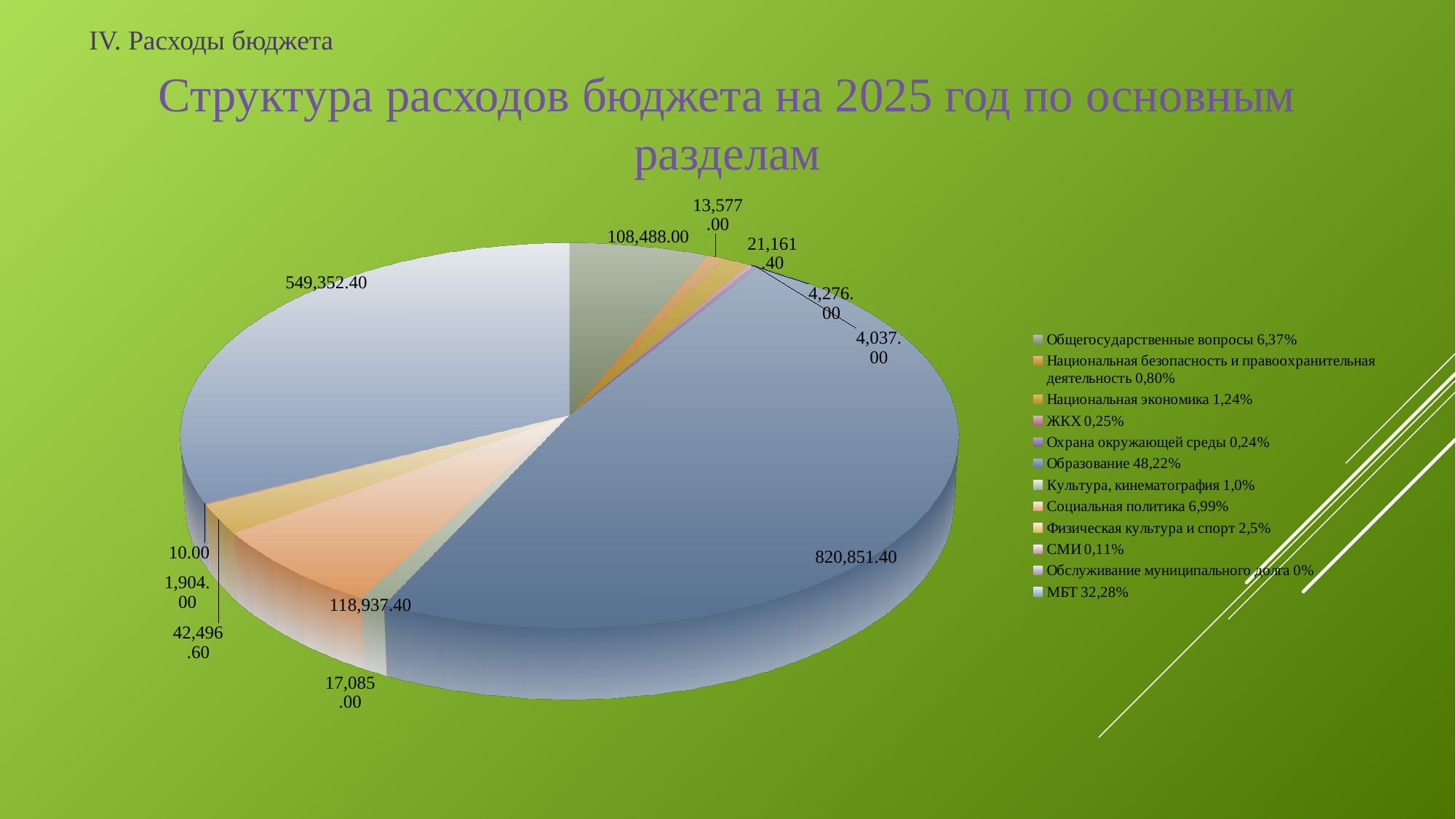
What is the value shown for Общегосударственные вопросы? 108,488.00 Which category has the largest slice of the pie? Образование What is the difference between the values for Образование and МБТ? 271,499.00 Which category has the smallest slice of the pie? Обслуживание муниципального долга What is the value shown for МБТ? 549,352.40 What kind of chart is shown on the slide? pie chart What is the value shown for Образование? 820,851.40 What share of the pie does МБТ account for, according to the legend? 32,28% How many categories does the legend of the pie chart list? 12 What share of the pie does Образование account for, according to the legend? 48,22% What is the value shown for Социальная политика? 118,937.40 Which is larger, the value for Социальная политика or the value for Общегосударственные вопросы? Социальная политика